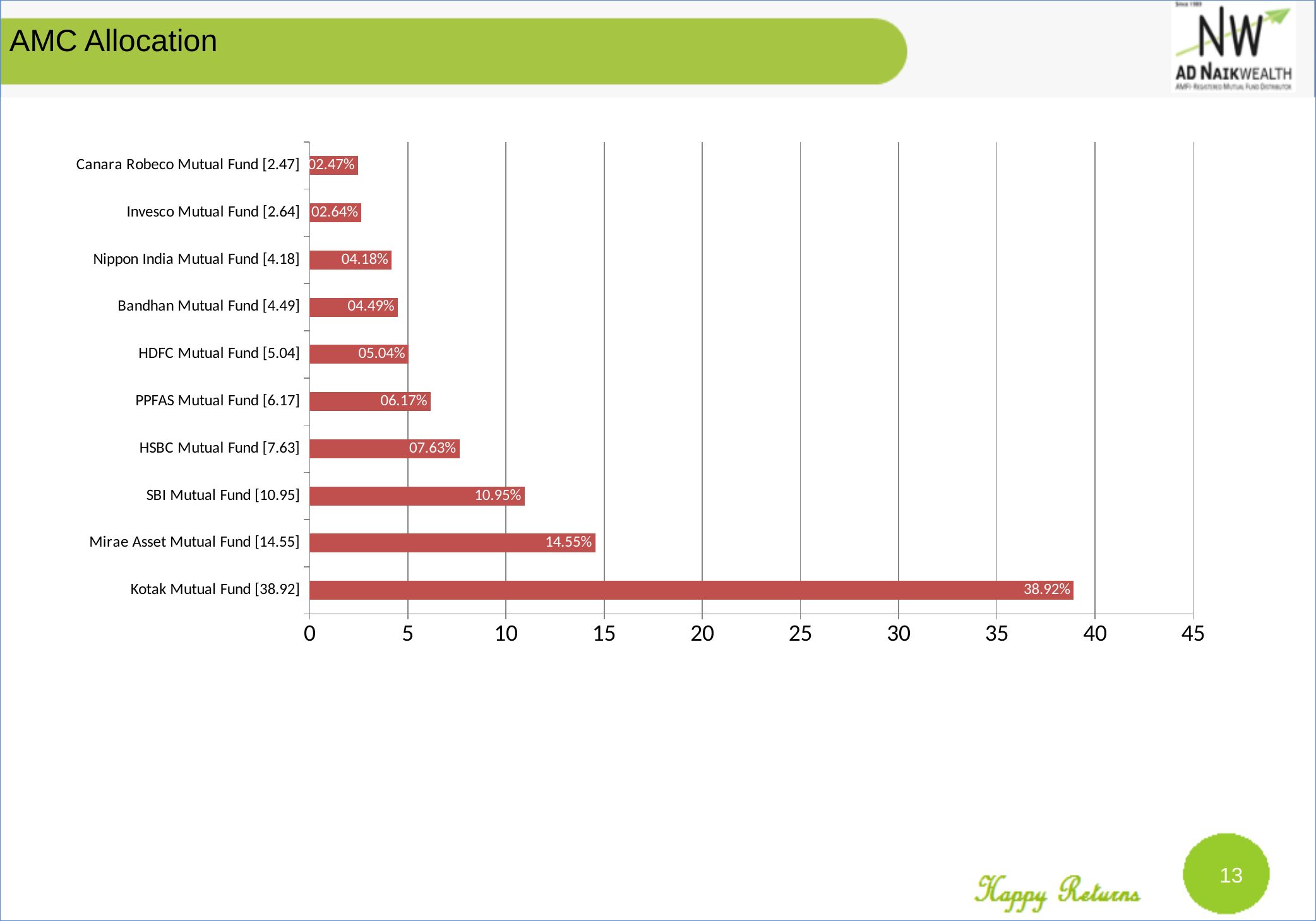
What is the value shown for Kotak Mutual Fund? 38.92% Which fund has the lowest allocation? Canara Robeco Mutual Fund What is the difference between the values for Kotak Mutual Fund and Mirae Asset Mutual Fund? 24.37% Which fund has the highest allocation? Kotak Mutual Fund What is the value shown for HDFC Mutual Fund? 05.04% Which is larger, the value for Mirae Asset Mutual Fund or the value for SBI Mutual Fund? Mirae Asset Mutual Fund Is the value for Kotak Mutual Fund greater or less than 35? greater What is the title of the slide containing the chart? AMC Allocation What is the value shown for SBI Mutual Fund? 10.95% What kind of chart is shown on the slide? bar chart What is the difference between the values for SBI Mutual Fund and HSBC Mutual Fund? 3.32% How many funds are shown in the chart? 10